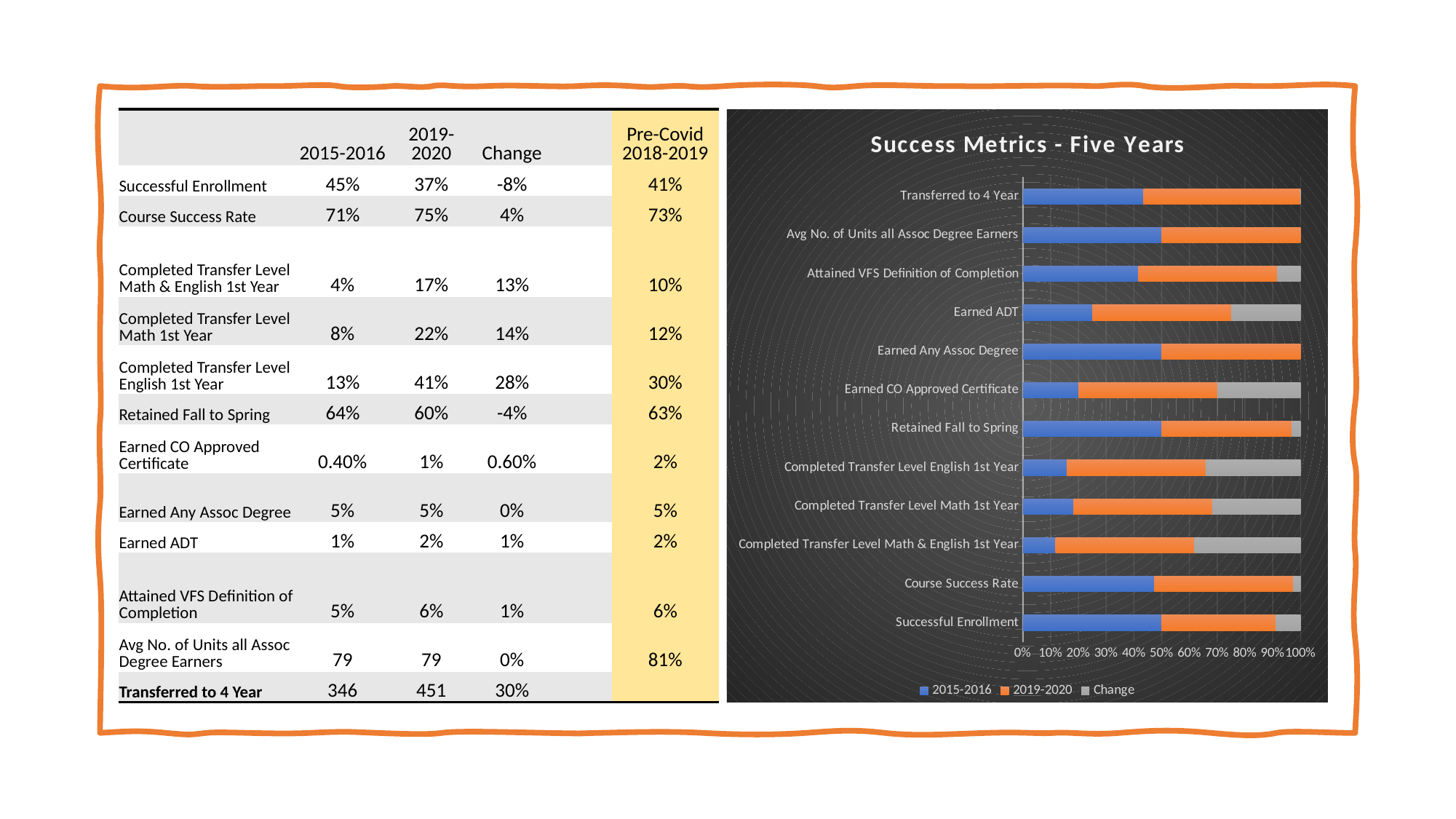
What are the three series named in the legend of the "Success Metrics - Five Years" chart? 2015-2016, 2019-2020, Change In the "Success Metrics - Five Years" chart, is the 2015-2016 segment larger for "Course Success Rate" or for "Earned ADT"? Course Success Rate In the "Success Metrics - Five Years" chart, which category is listed at the top of the bars? Transferred to 4 Year How many categories are plotted in the "Success Metrics - Five Years" chart? 12 In the "Success Metrics - Five Years" chart, which category is listed at the bottom of the bars? Successful Enrollment What kind of chart is shown under the title "Success Metrics - Five Years"? Stacked bar chart In the "Success Metrics - Five Years" chart, is the 2015-2016 segment for "Earned ADT" greater or less than 40%? less In the "Success Metrics - Five Years" chart, which category has the largest "Change" (grey) segment? Completed Transfer Level Math & English 1st Year In the "Success Metrics - Five Years" chart, which category has the smallest 2015-2016 segment? Completed Transfer Level Math & English 1st Year How many series does the legend of the "Success Metrics - Five Years" chart list? 3 In the "Success Metrics - Five Years" chart, is the 2015-2016 segment for "Completed Transfer Level Math & English 1st Year" greater or less than 20%? less Which colour represents the "Change" series in the "Success Metrics - Five Years" chart? Grey